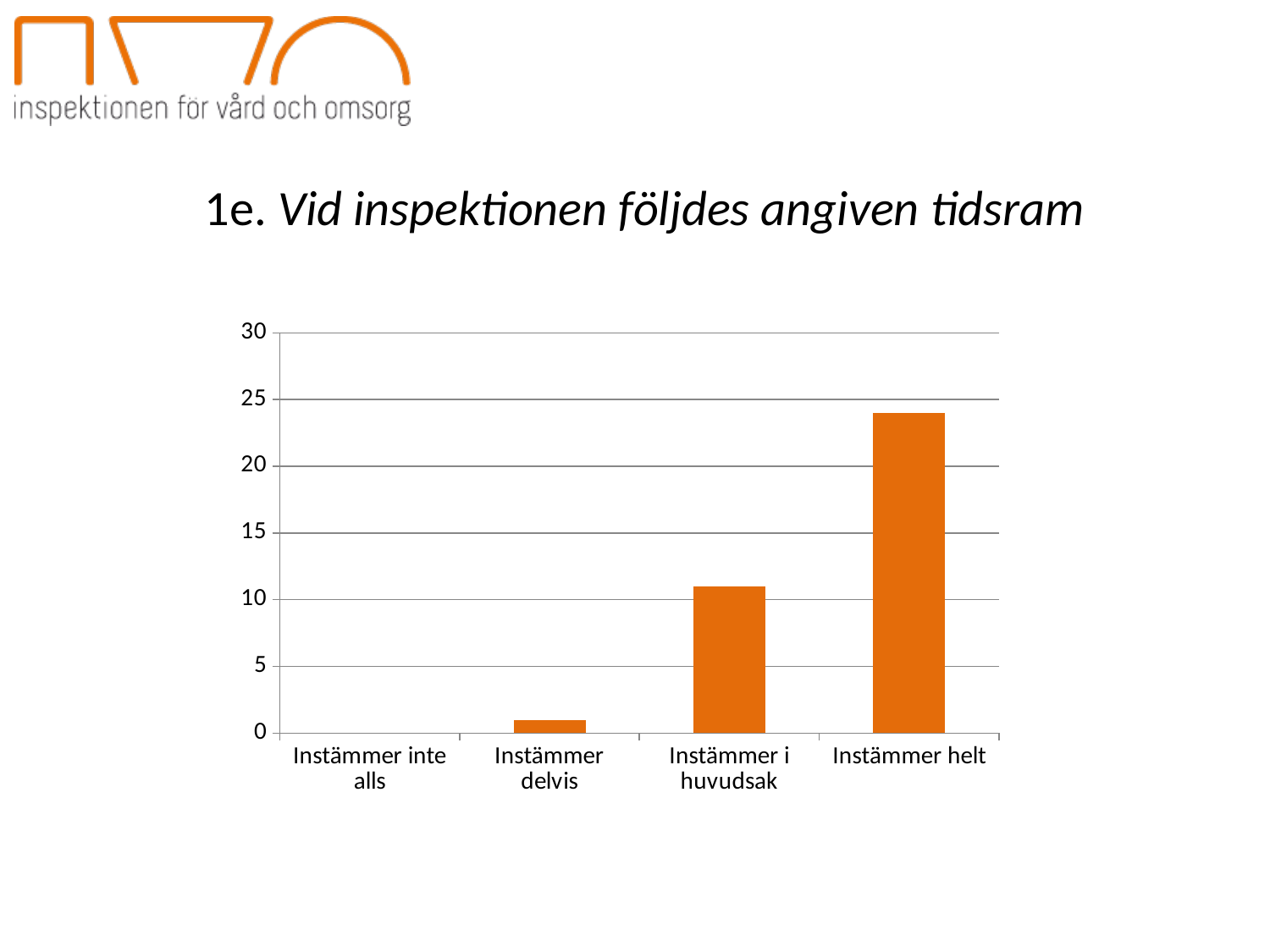
Which is larger, the value for Instämmer i huvudsak or the value for Instämmer delvis? Instämmer i huvudsak Is the value for Instämmer helt greater or less than 20? greater Is the value for Instämmer helt greater or less than 25? less Which category has the highest bar in the chart? Instämmer helt How many categories are shown on the x axis of the chart? 4 What kind of chart is shown on the slide? bar chart Is the value for Instämmer delvis greater or less than 5? less Do the bar values rise or fall from left to right along the x axis? rise Which category has the lowest value in the chart? Instämmer inte alls What is the title of the chart on the slide? 1e. Vid inspektionen följdes angiven tidsram